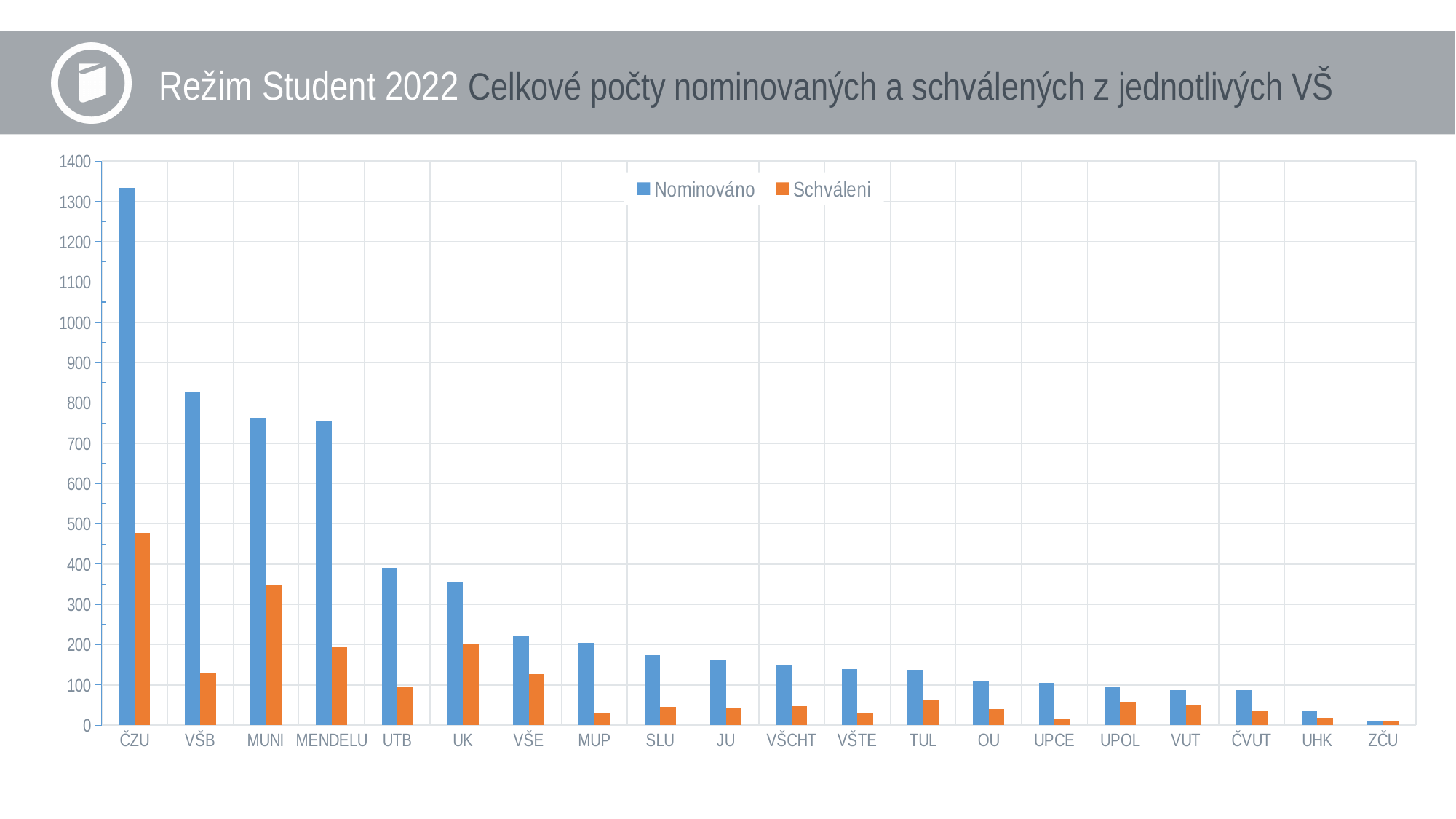
How many universities (categories) are shown on the x axis? 20 Which is larger, the Nominováno value for VŠB or for MUNI? VŠB Is the Nominováno value for VŠB greater or less than 800? greater Which university has the highest Schváleni value? ČZU Which university has the highest Nominováno value? ČZU Do the Nominováno values generally rise or fall from left to right along the x axis? fall Is the Schváleni value for ČZU greater or less than 500? less Is the Nominováno value for ČZU greater or less than 1200? greater Which university has the lowest Nominováno value? ZČU How many series does the legend list? 2 What kind of chart is shown on the slide? bar chart